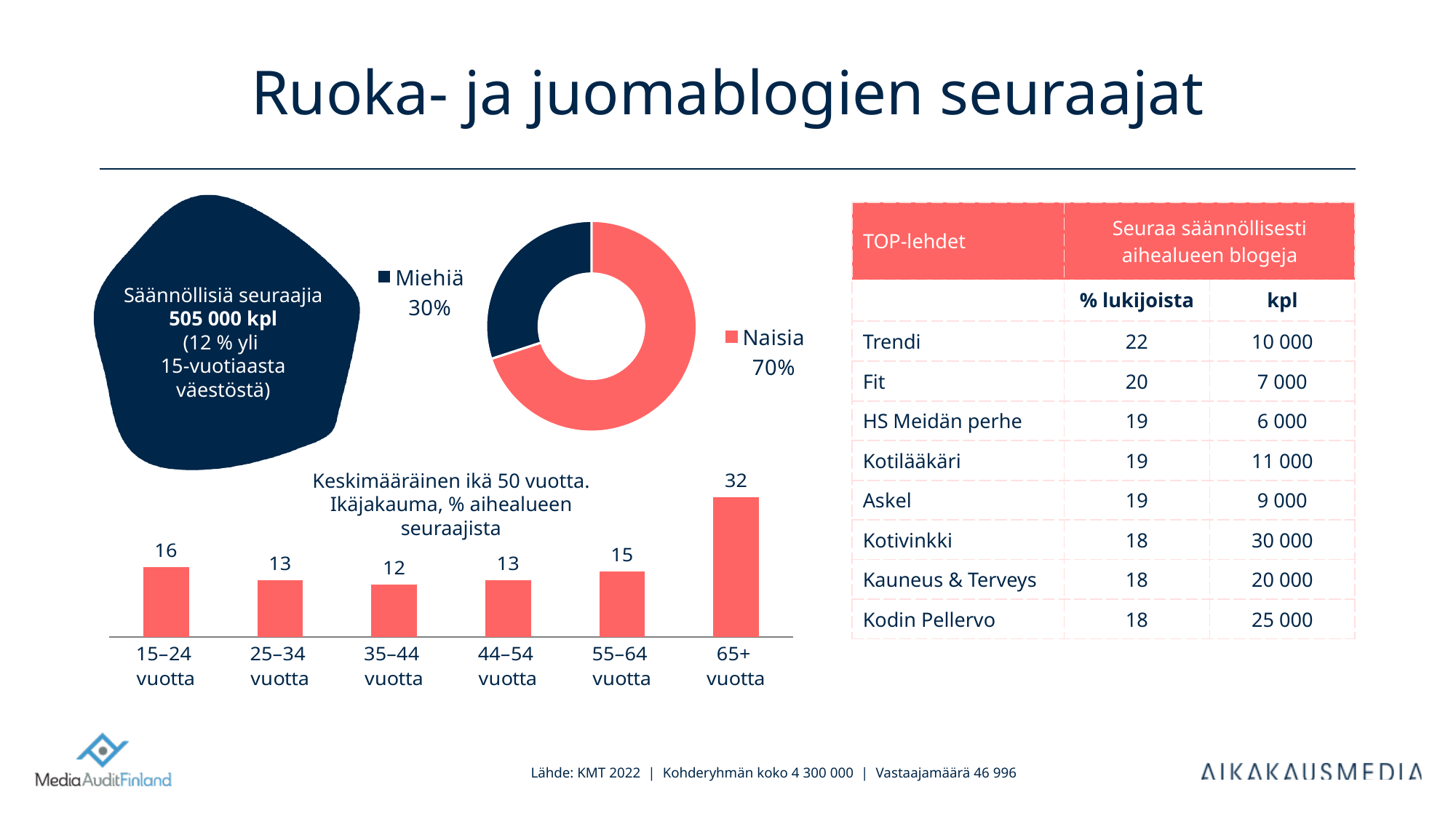
In the donut chart, what share of followers are women (Naisia)? 70% In the age distribution bar chart, what is the difference between the values for 65+ vuotta and 55–64 vuotta? 17 In the age distribution bar chart, which age group has the lowest value? 35–44 vuotta In the age distribution bar chart, which age group has the highest value? 65+ vuotta What kind of chart shows the split between Miehiä and Naisia? Donut (pie) chart In the donut chart, what share of followers are men (Miehiä)? 30% What kind of chart is used for the age distribution (Ikäjakauma)? Bar chart How many categories does the donut chart's legend list? 2 How many age groups are shown in the age distribution bar chart? 6 In the donut chart, which group is larger, Miehiä or Naisia? Naisia In the age distribution bar chart, what is the value for 15–24 vuotta? 16 In the age distribution bar chart, what is the value for 65+ vuotta? 32